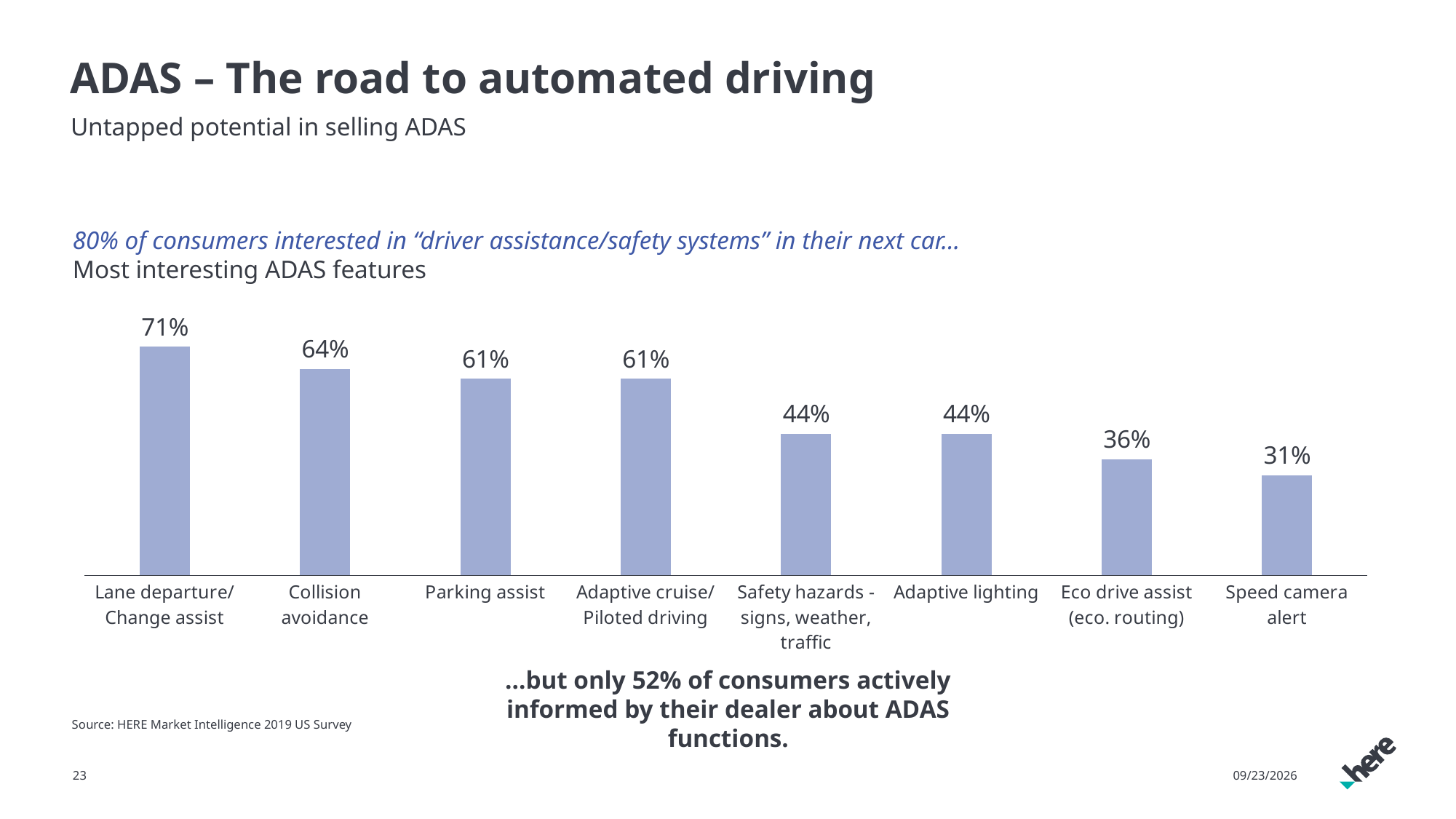
What is the value for Eco drive assist (eco. routing)? 36% Which is larger, Parking assist or Eco drive assist (eco. routing)? Parking assist What is the value for Adaptive lighting? 44% What percentage of consumers find Lane departure/Change assist interesting? 71% Which ADAS feature has the highest value? Lane departure/Change assist What is the value for Collision avoidance? 64% How many ADAS features are shown in the chart? 8 What kind of chart is shown on the slide? Bar chart Which ADAS feature has the lowest value? Speed camera alert Do the values rise or fall from left to right across the chart? Fall What is the difference between Lane departure/Change assist and Speed camera alert? 40% What is the difference between Collision avoidance and Parking assist? 3%